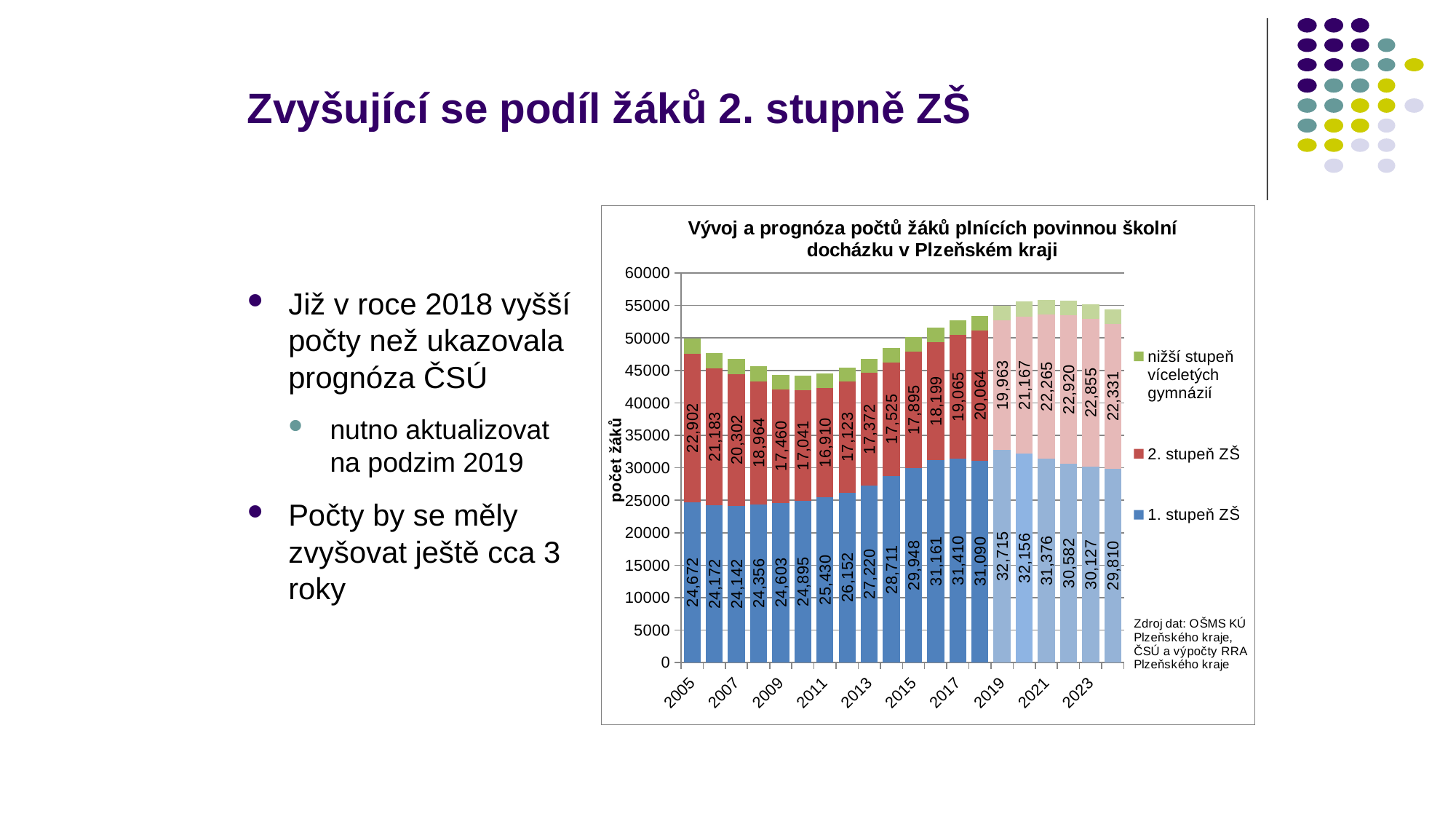
What is the value for 2. stupeň ZŠ in 2011? 16,910 How many years (bars) are shown on the chart? 20 Which is larger: the 2. stupeň ZŠ value in 2005 or in 2024? 2005 What is the value for 2. stupeň ZŠ in 2022? 22,920 Does the value for 1. stupeň ZŠ rise or fall from 2011 to 2017? Rise What kind of chart is shown on the slide? Stacked bar chart How many series does the legend list? 3 What is the difference between the 1. stupeň ZŠ values for 2019 and 2005? 8,043 What is the value for 1. stupeň ZŠ in 2005? 24,672 In which year is the value for 1. stupeň ZŠ highest? 2019 In which year is the value for 2. stupeň ZŠ lowest? 2011 Is the total height of the stacked bar for 2018 greater or less than 50000? greater